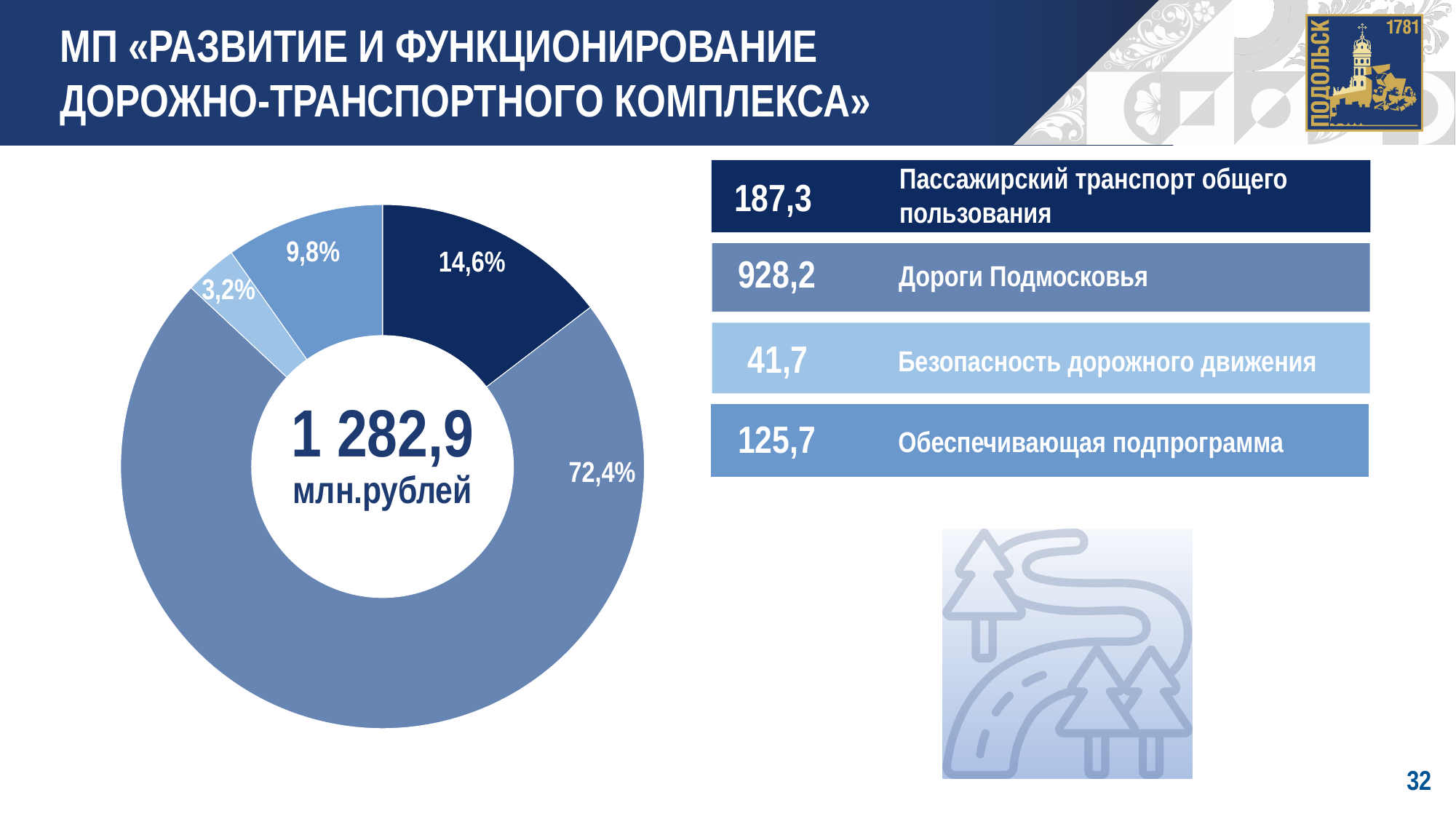
What value (in млн. рублей) is listed for «Безопасность дорожного движения»? 41,7 Which category has the smallest share of the donut chart? Безопасность дорожного движения What percentage share does the slice for «Дороги Подмосковья» have? 72,4% What percentage share does the slice for «Пассажирский транспорт общего пользования» have? 14,6% What percentage share does the slice for «Безопасность дорожного движения» have? 3,2% Which category has the largest share of the donut chart? Дороги Подмосковья What kind of chart is shown on the slide? pie chart (donut) What value (in млн. рублей) is listed for «Дороги Подмосковья»? 928,2 What is the difference between the values for «Пассажирский транспорт общего пользования» (187,3) and «Обеспечивающая подпрограмма» (125,7)? 61,6 What total value is printed in the centre of the donut chart? 1 282,9 млн.рублей How many slices does the donut chart have? 4